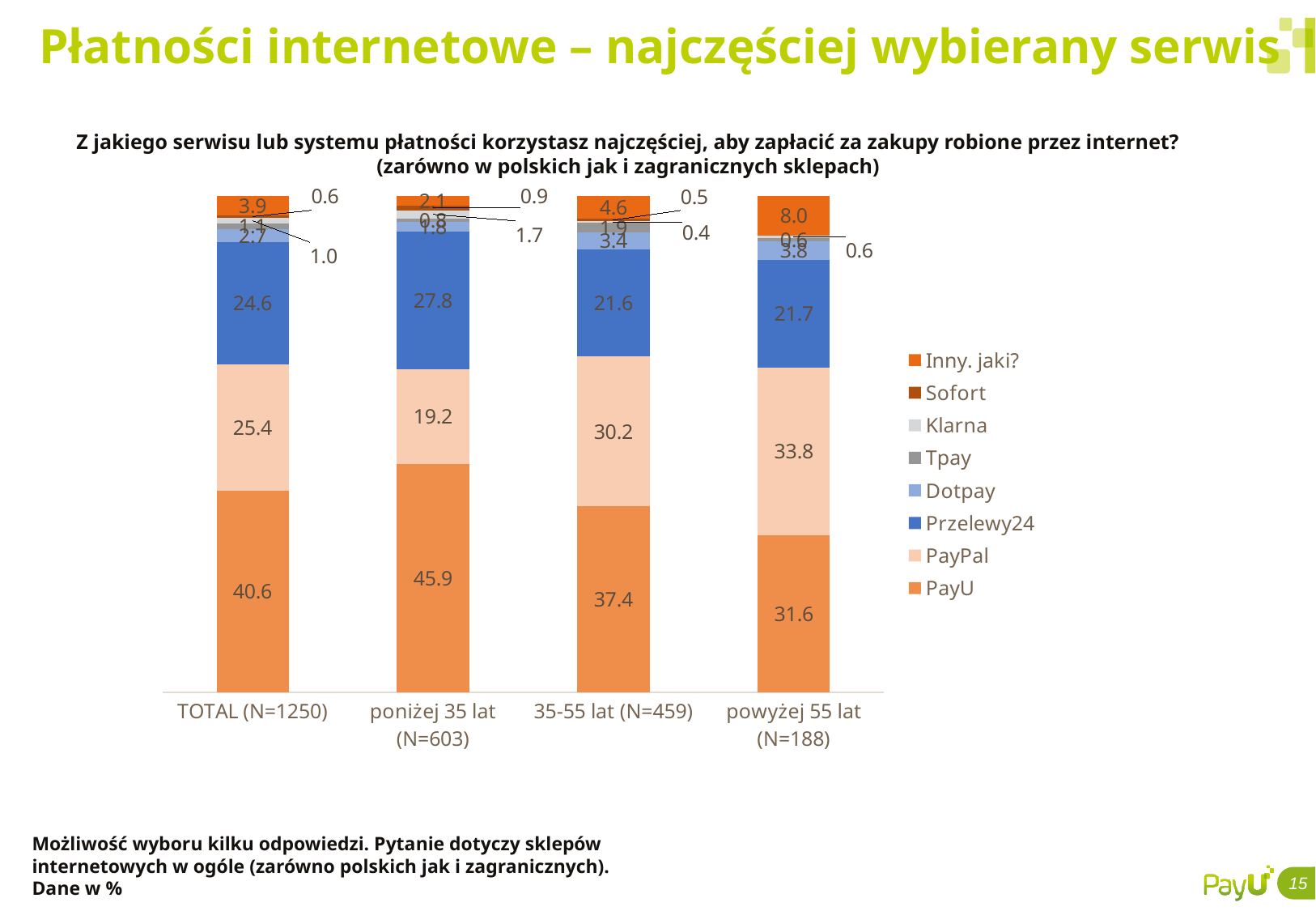
What kind of chart is shown on the slide? Stacked bar chart How many groups (bars) are shown on the x axis? 4 What is the PayU value for the TOTAL (N=1250) group? 40.6 How many series does the legend list? 8 Which group has the lowest PayPal value? poniżej 35 lat (N=603) Which is larger for the 35-55 lat (N=459) group: PayU or PayPal? PayU What is the 'Inny. jaki?' value for the 35-55 lat (N=459) group? 4.6 Which age group has the highest PayU value? poniżej 35 lat (N=603) Which series is shown at the bottom of each stacked bar? PayU What is the Przelewy24 value for the poniżej 35 lat (N=603) group? 27.8 What is the PayPal value for the powyżej 55 lat (N=188) group? 33.8 What is the difference between the PayU values for poniżej 35 lat (N=603) and powyżej 55 lat (N=188)? 14.3